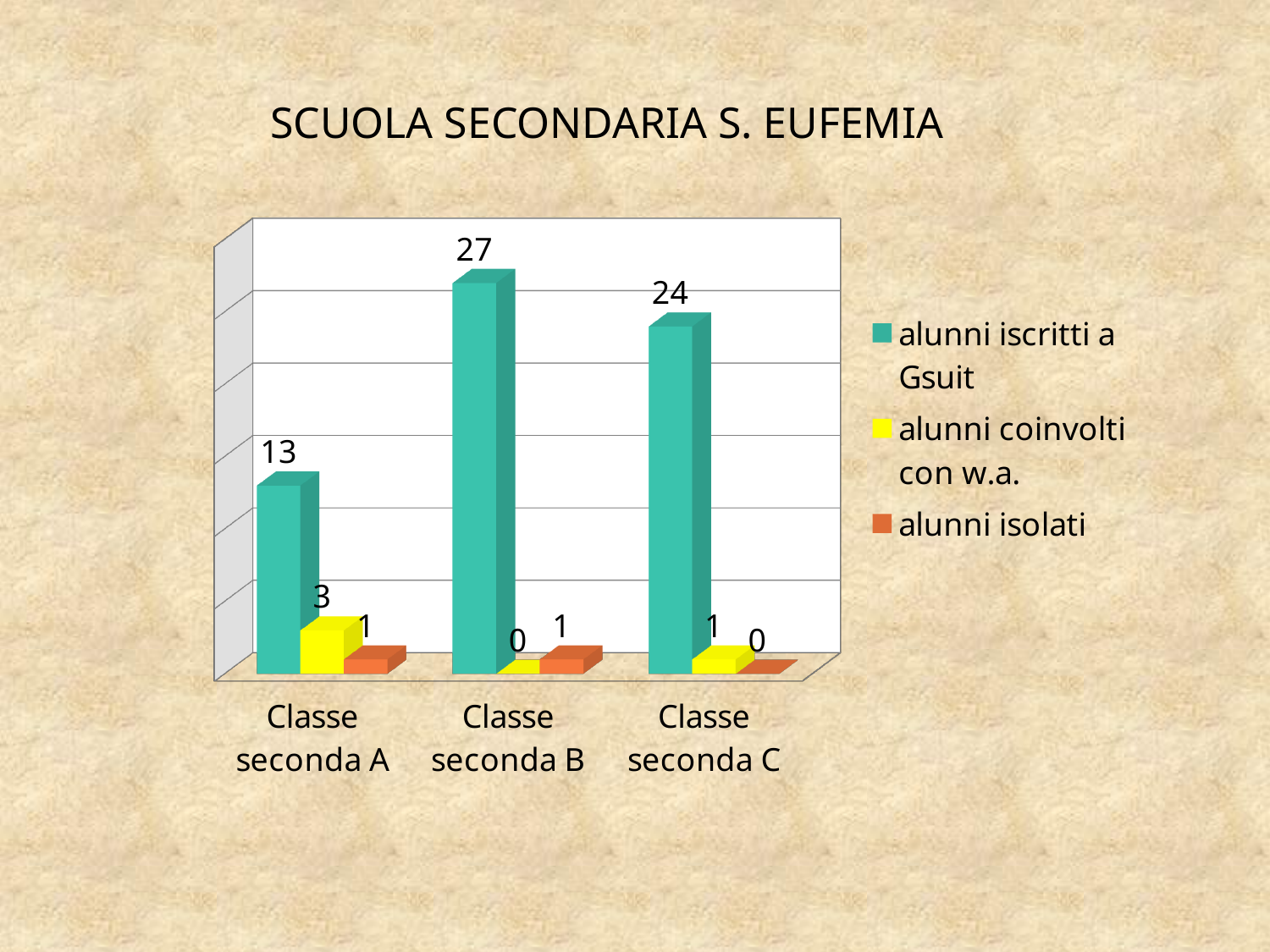
What kind of chart is shown on the slide? Bar chart Which colour represents 'alunni isolati' in the legend? Orange What is the difference between 'alunni iscritti a Gsuit' in Classe seconda B and Classe seconda C? 3 Which class has the highest value for 'alunni iscritti a Gsuit'? Classe seconda B What is the value for 'alunni isolati' in Classe seconda C? 0 What is the value for 'alunni iscritti a Gsuit' in Classe seconda B? 27 Which class has the lowest value for 'alunni iscritti a Gsuit'? Classe seconda A What is the title of the slide? SCUOLA SECONDARIA S. EUFEMIA What is the value for 'alunni coinvolti con w.a.' in Classe seconda A? 3 How many classes are shown on the x axis? 3 How many series does the legend list? 3 Which is larger: 'alunni iscritti a Gsuit' in Classe seconda A or in Classe seconda C? Classe seconda C